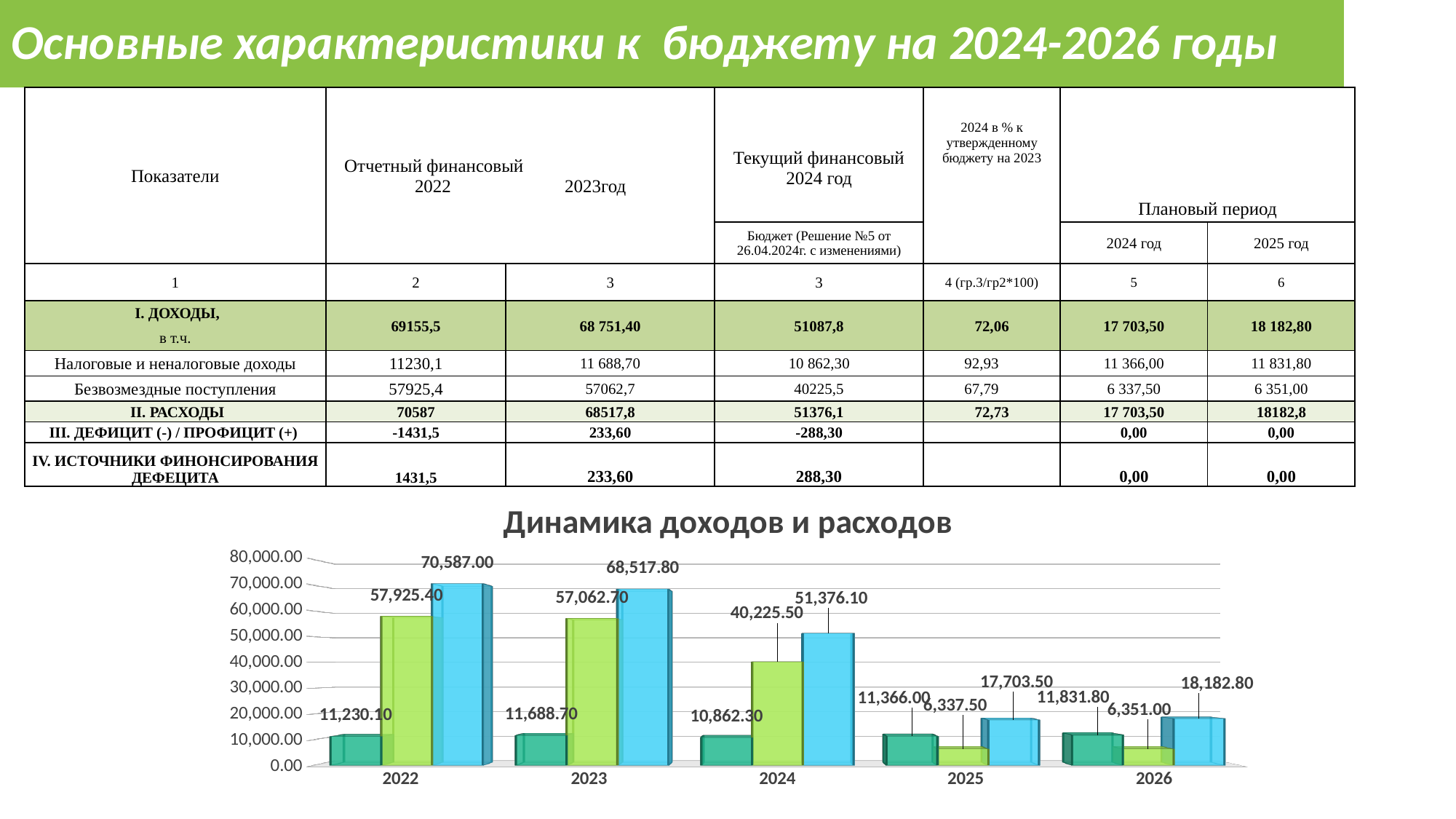
In the "Динамика доходов и расходов" chart, what is the value of the light green bar for 2024? 40,225.50 In the "Динамика доходов и расходов" chart, which year has the lowest light green bar? 2025 In the "Динамика доходов и расходов" chart, what is the value of the dark green bar for 2026? 11,831.80 In the "Динамика доходов и расходов" chart, is the blue bar for 2025 greater or less than 20,000.00? less How many years are shown on the x axis of the "Динамика доходов и расходов" chart? 5 In the "Динамика доходов и расходов" chart, do the blue bar values rise or fall from 2022 to 2025? fall What is the title of the chart on the slide? Динамика доходов и расходов In the "Динамика доходов и расходов" chart, what is the difference between the blue bar values for 2022 and 2023? 2,069.20 In the "Динамика доходов и расходов" chart, what is the value of the blue bar for 2022? 70,587.00 In the "Динамика доходов и расходов" chart, which year has the highest blue bar? 2022 In the "Динамика доходов и расходов" chart, which is larger: the light green bar for 2022 or the light green bar for 2023? 2022 What kind of chart is "Динамика доходов и расходов"? bar chart